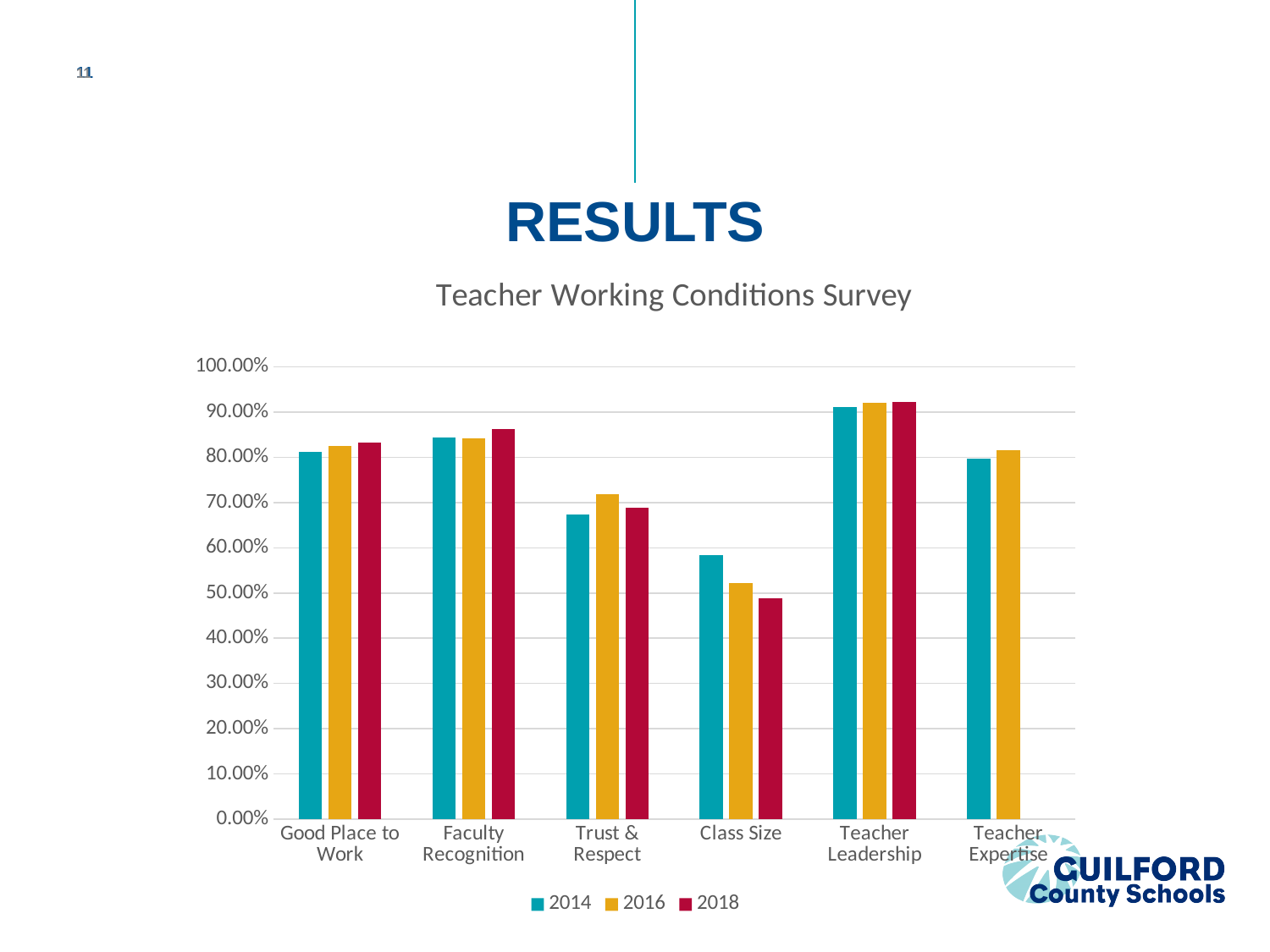
Is the 2014 value for Class Size greater or less than 50.00%? greater Is the 2014 value for Trust & Respect greater or less than 70.00%? less Is the 2018 value for Teacher Leadership greater or less than 90.00%? greater For Class Size, do the values rise or fall from 2014 to 2018? fall How many series does the legend list? 3 For Trust & Respect, which is larger: the 2014 value or the 2016 value? 2016 How many categories are shown on the x axis? 6 Which category has the highest value for 2014? Teacher Leadership Which category has the lowest value for 2018? Class Size What is the title of the chart? Teacher Working Conditions Survey What kind of chart is shown on the slide? Bar chart